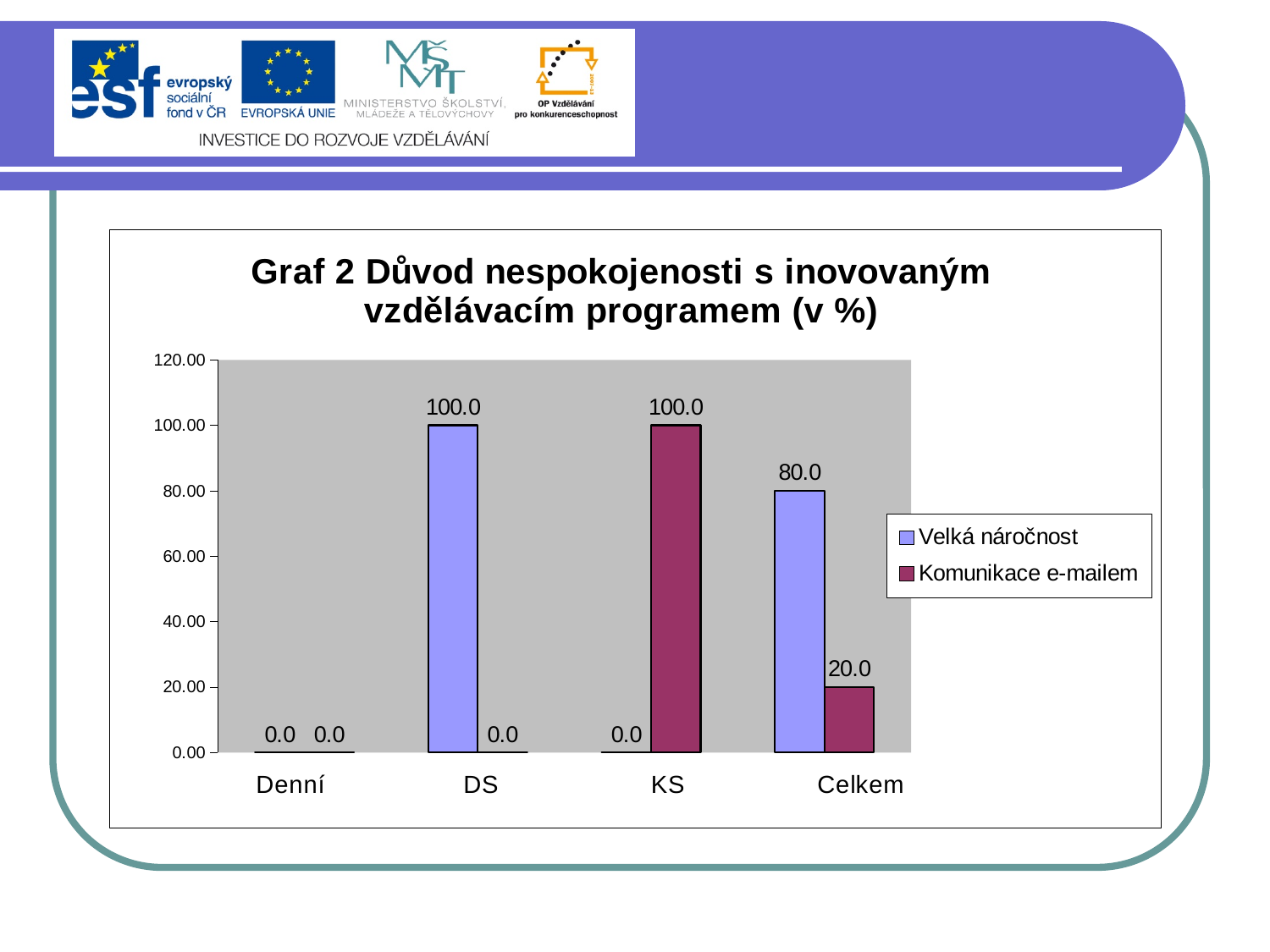
What is the value for Velká náročnost in the Celkem category? 80.0 How many series does the legend list? 2 What is the value for Komunikace e-mailem in the KS category? 100.0 In the Celkem category, which is larger: Velká náročnost or Komunikace e-mailem? Velká náročnost What is the value for Velká náročnost in the Denní category? 0.0 How many categories are shown on the x axis? 4 What is the value for Velká náročnost in the DS category? 100.0 What kind of chart is shown on the slide? Bar chart What is the title of the chart? Graf 2 Důvod nespokojenosti s inovovaným vzdělávacím programem (v %) What is the value for Komunikace e-mailem in the Celkem category? 20.0 What is the difference between Velká náročnost and Komunikace e-mailem in the Celkem category? 60.0 Which category has the lowest value for Komunikace e-mailem? Denní and DS (both 0.0)